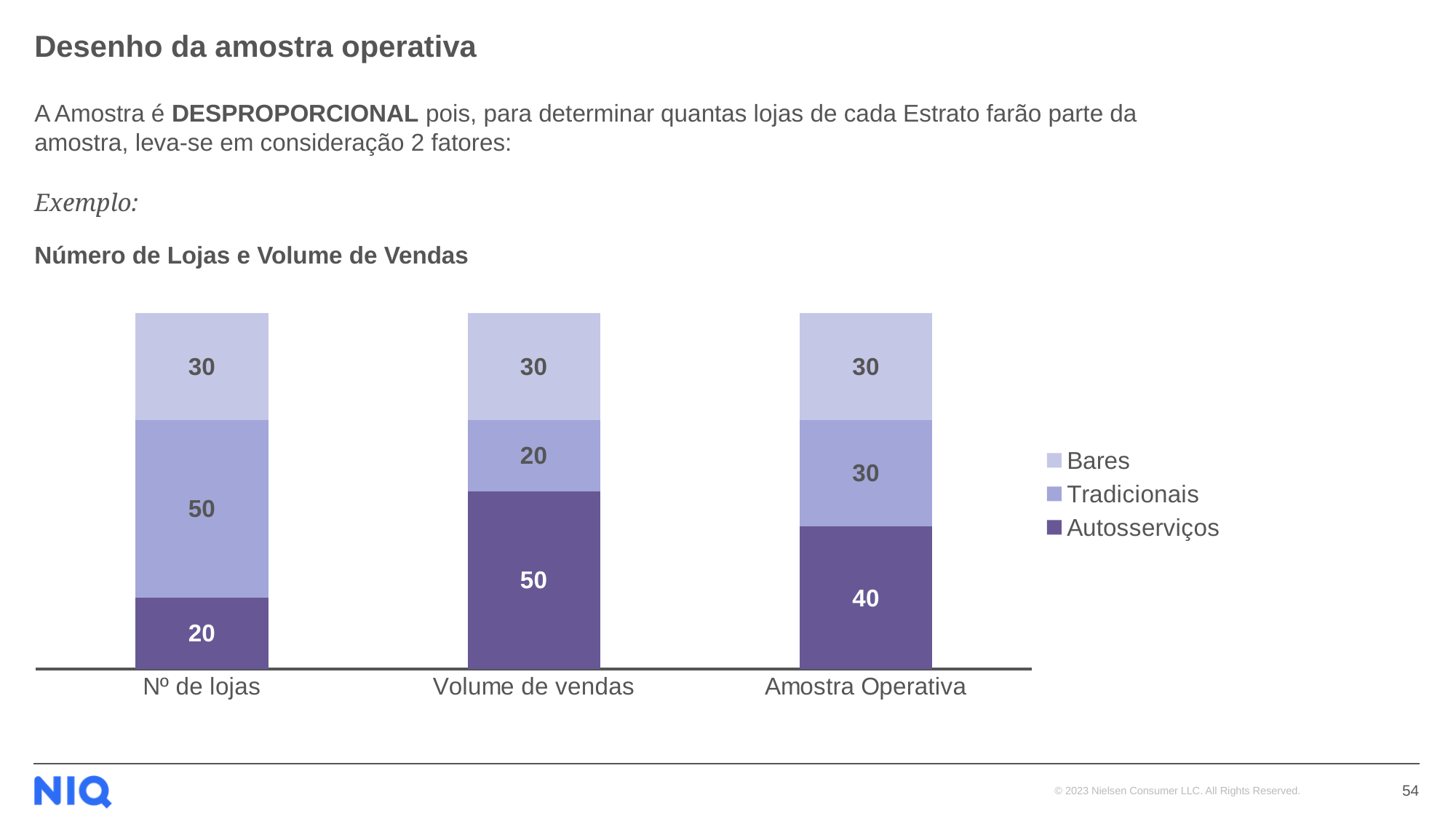
How many series does the legend list? 3 Which category has the highest Autosserviços value? Volume de vendas What is the value for Tradicionais in the Volume de vendas bar? 20 Which is larger: Tradicionais for Nº de lojas or Tradicionais for Amostra Operativa? Nº de lojas What is the value for Autosserviços in the Amostra Operativa bar? 40 What is the total of the Amostra Operativa stacked bar? 100 Which category has the lowest Tradicionais value? Volume de vendas What is the value for Bares in the Amostra Operativa bar? 30 What is the difference between the Autosserviços values for Volume de vendas and Nº de lojas? 30 What is the value for Autosserviços in the Nº de lojas bar? 20 How many categories are shown on the x axis? 3 What kind of chart is shown? Stacked bar chart